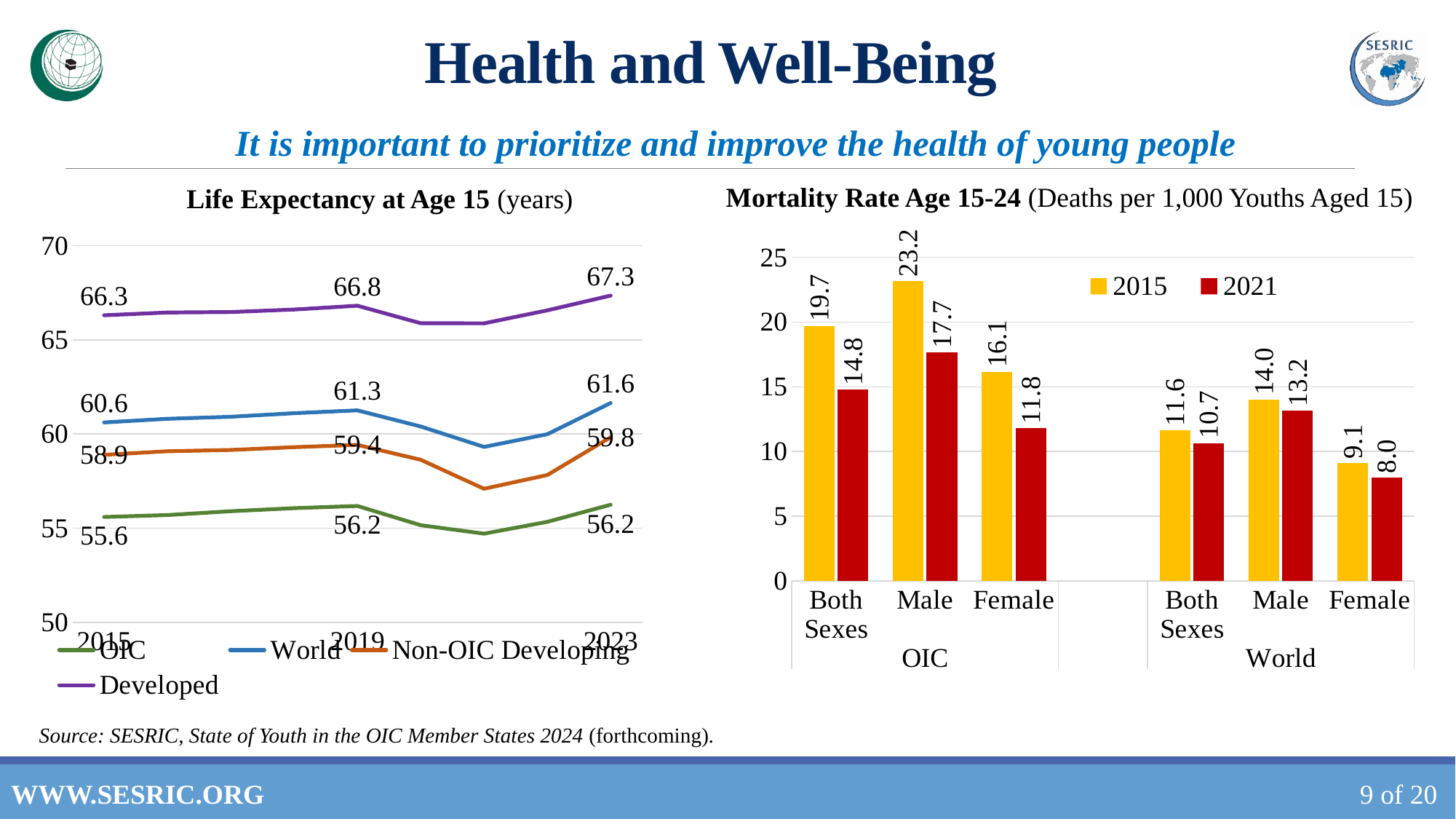
What kind of chart is the Mortality Rate Age 15-24 chart? bar chart In the Mortality Rate Age 15-24 chart, which is larger: the 2021 value for OIC Female or the 2021 value for World Male? World Male (13.2) In the Life Expectancy at Age 15 chart, what is the value for Developed in 2023? 67.3 In the Life Expectancy at Age 15 chart, what is the value for OIC in 2015? 55.6 In the Mortality Rate Age 15-24 chart, what is the difference between the 2015 and 2021 values for OIC Both Sexes? 4.9 In the Life Expectancy at Age 15 chart, which series has the highest values? Developed In the Mortality Rate Age 15-24 chart, what is the 2021 value for OIC Male? 17.7 In the Mortality Rate Age 15-24 chart, which bar has the highest value? OIC Male, 2015 (23.2) In the Mortality Rate Age 15-24 chart, what is the 2015 value for World Female? 9.1 In the Life Expectancy at Age 15 chart, how many series does the legend list? 4 In the Life Expectancy at Age 15 chart, what is the value for Non-OIC Developing in 2019? 59.4 In the Life Expectancy at Age 15 chart, what is the difference between the World value in 2023 and in 2015? 1.0